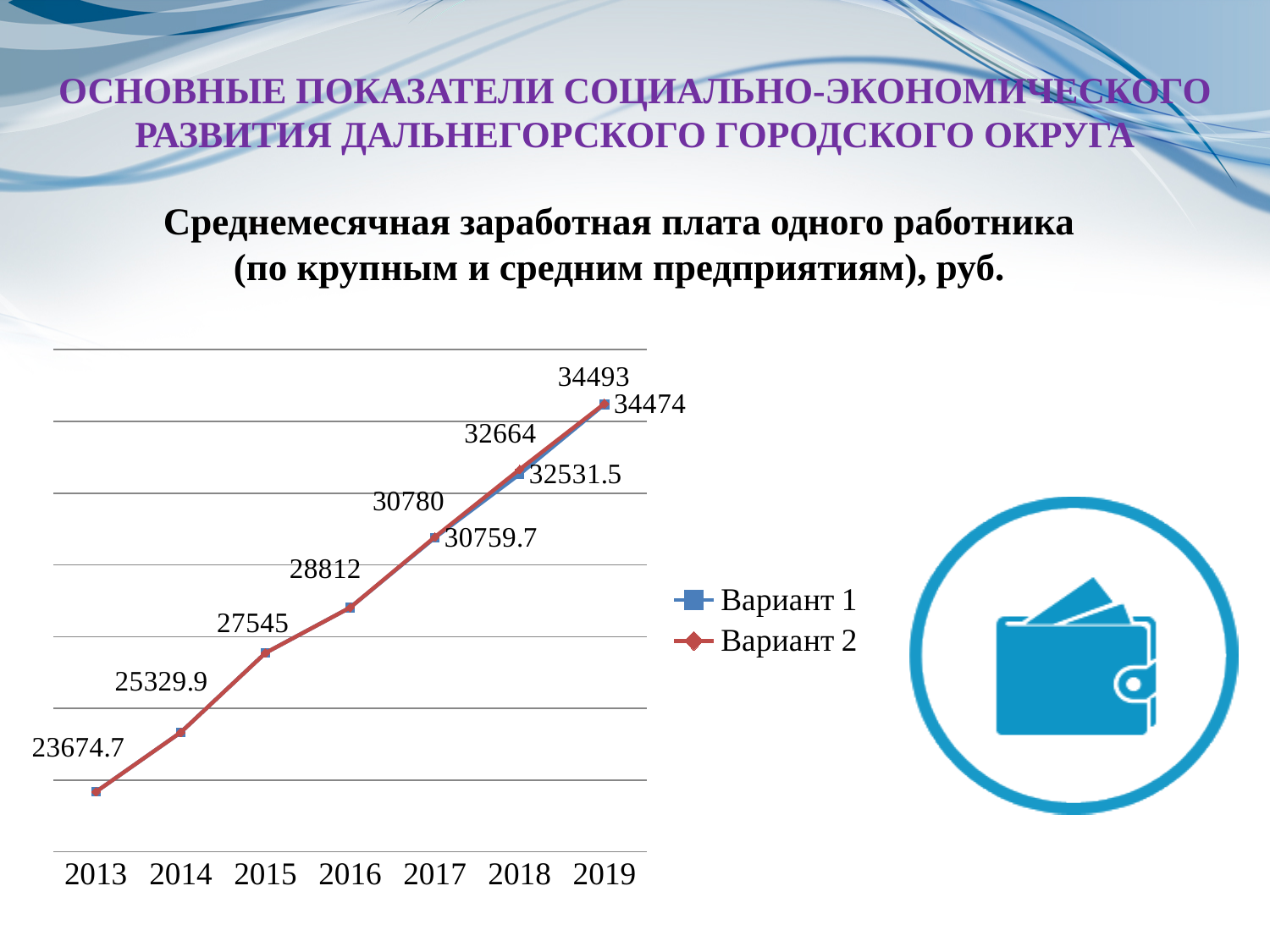
How many years are shown on the x axis? 7 What are the names of the two series in the legend? Вариант 1, Вариант 2 What is the value labelled for 2014? 25329.9 What type of chart is shown on the slide? line chart What is the larger of the two values labelled for 2019? 34493 Which year has the lowest value on the chart? 2013 Do the values rise or fall from 2013 to 2019? rise What is the value labelled for 2016? 28812 What is the value labelled for 2015? 27545 How many series does the legend list? 2 What is the average monthly wage value labelled for 2013? 23674.7 What is the difference between the values for 2016 and 2015? 1267